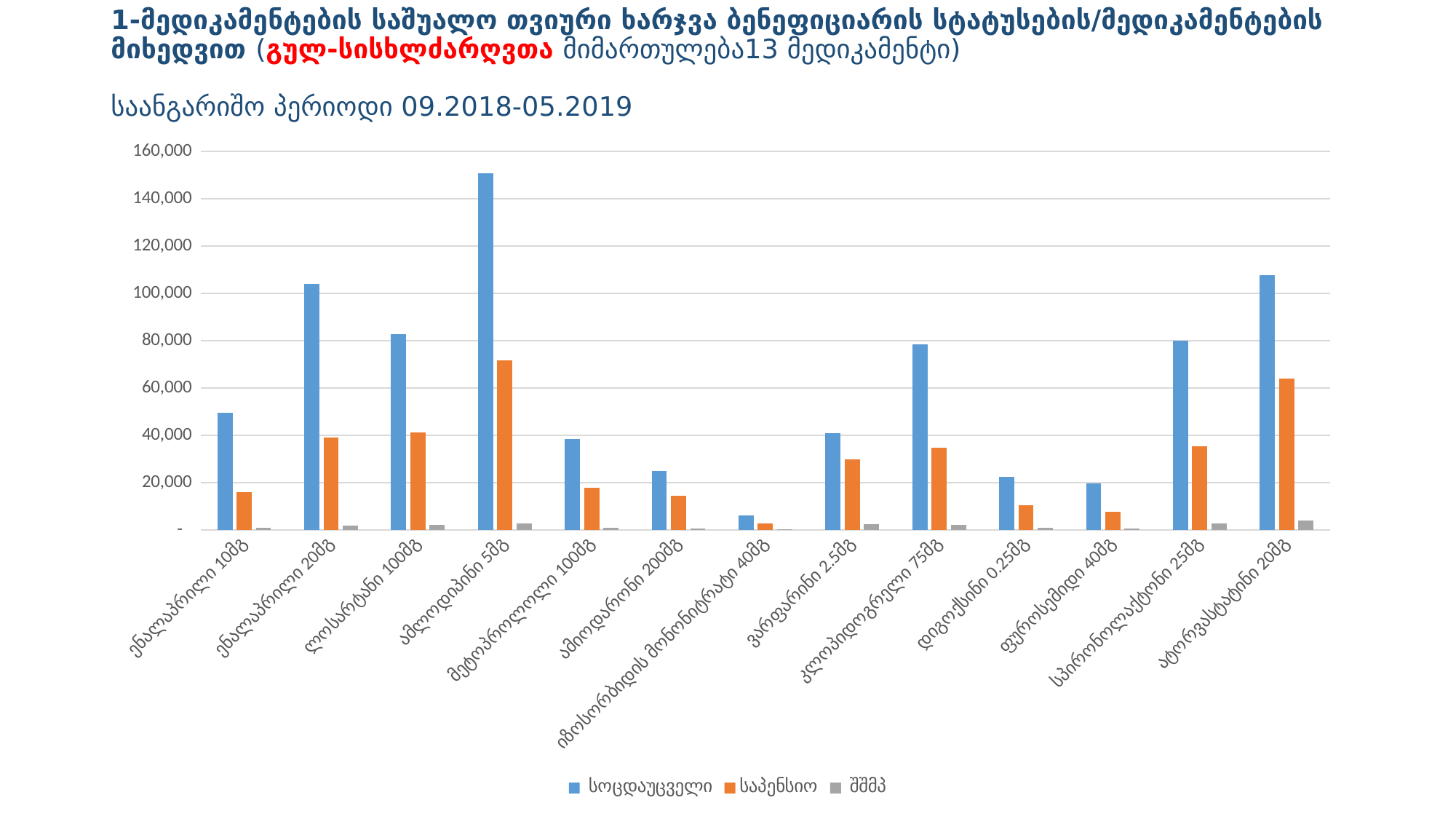
Is the საპენსიო value for ატორვასტატინი 20მგ greater or less than 60,000? greater Which medication has the lowest value for the სოციალურად დაუცველი series? იზოსორბიდის მონონიტრატი 40მგ What kind of chart is shown on the slide? bar chart Which medication has the highest value for the სოციალურად დაუცველი series? ამლოდიპინი 5მგ For the სოციალურად დაუცველი series, which is larger: ენალაპრილი 20მგ or ლოსარტანი 100მგ? ენალაპრილი 20მგ Is the სოციალურად დაუცველი value for ამლოდიპინი 5მგ greater or less than 140,000? greater How many medication categories are shown on the x axis of the chart? 13 Which medication has the highest value for the საპენსიო series? ამლოდიპინი 5მგ What colour are the bars for the საპენსიო series? orange Is the სოციალურად დაუცველი value for ამიოდარონი 200მგ greater or less than 20,000? greater How many series does the chart legend list? 3